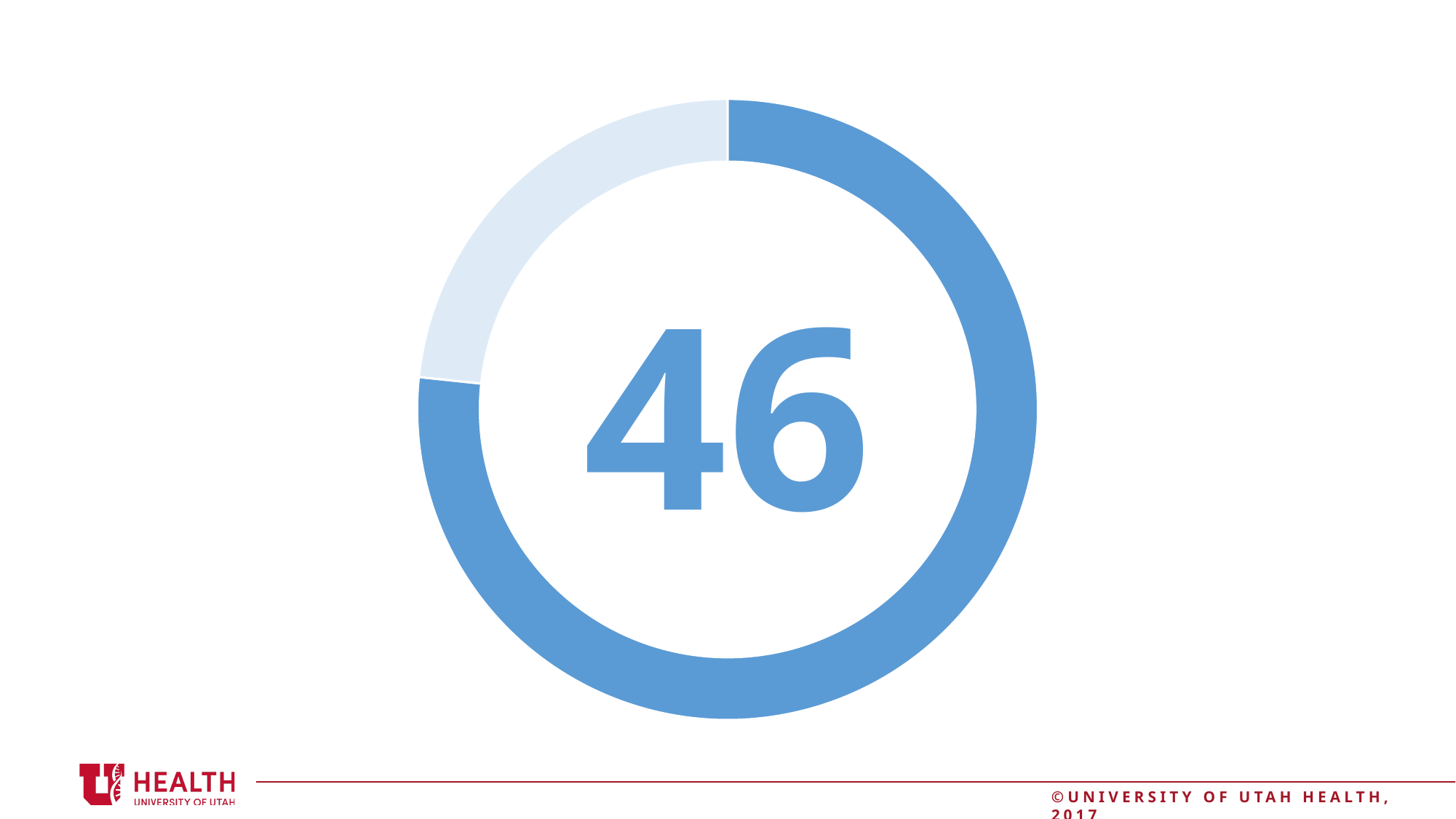
What colour is the smaller segment of the doughnut chart? light blue Does the light blue segment cover more or less than half of the doughnut chart? less What kind of chart is shown on the slide? doughnut chart What number is printed in the centre of the doughnut chart? 46 Which segment of the doughnut chart is larger, the dark blue one or the light blue one? dark blue Does the doughnut chart have a legend? No Does the dark blue segment cover more or less than half of the doughnut chart? more How many segments does the doughnut chart have? 2